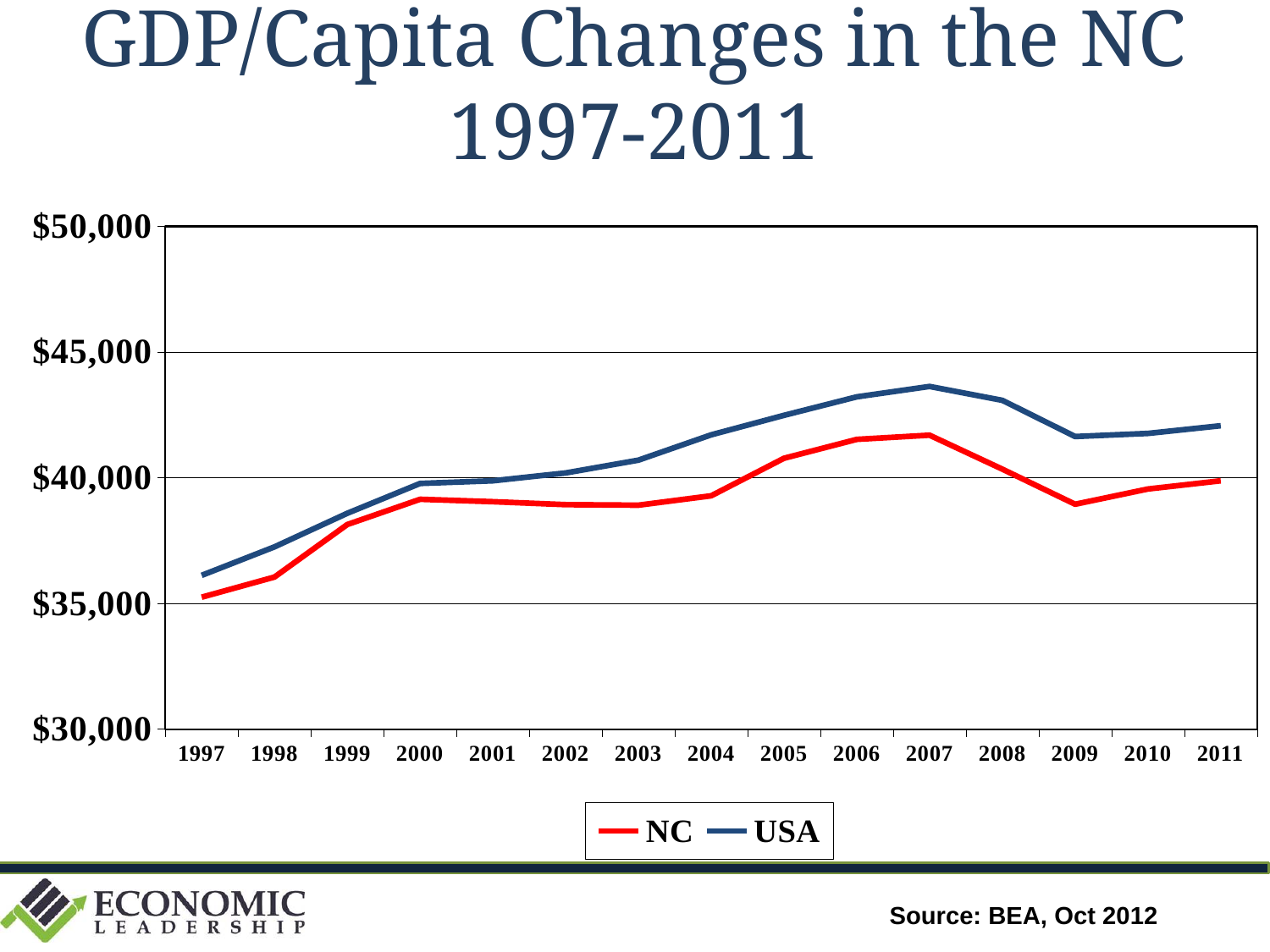
Is the value for NC in 2007 greater or less than $40,000? greater In which year does the USA series reach its highest value? 2007 What kind of chart is shown on the slide? Line chart Is the value for USA in 2011 greater or less than $40,000? greater Is the value for NC in 2009 greater or less than $40,000? less How many series does the legend list? 2 How many years are plotted along the x axis? 15 In 2005, which series has the higher value, NC or USA? USA Do the NC values rise or fall from 2007 to 2009? fall Which series is drawn in red? NC In which year is the NC series at its lowest value? 1997